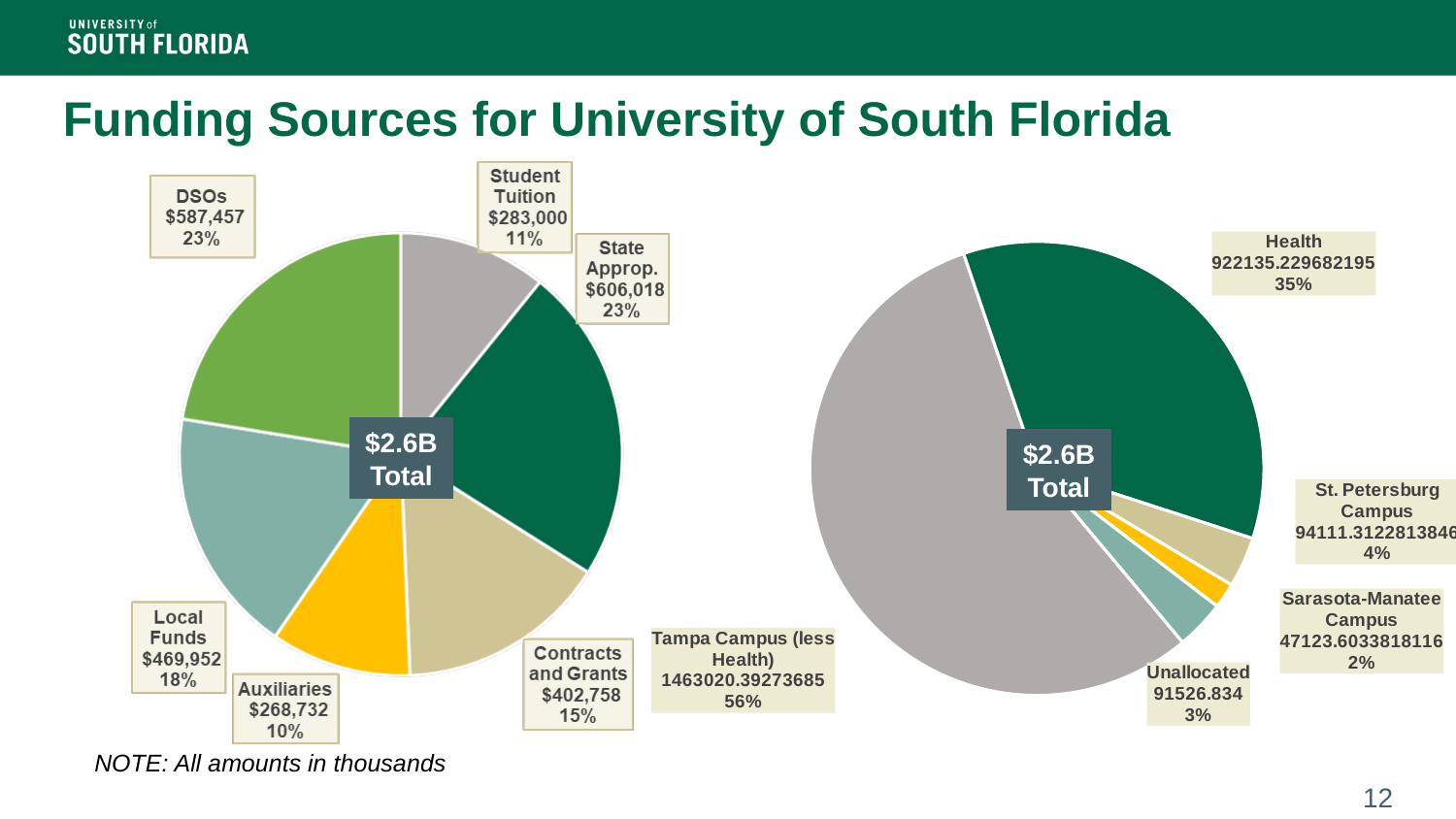
On the right pie chart, which category has the largest share? Tampa Campus (less Health) On the left pie chart, which is larger: Local Funds or Contracts and Grants? Local Funds On the left pie chart, what percentage share does State Approp. have? 23% On the right pie chart, which category has the smallest share? Sarasota-Manatee Campus What total is shown in the center of each pie chart? $2.6B Total How many slices does the right pie chart have? 5 On the left pie chart, which funding source has the smallest value? Auxiliaries How many slices does the left pie chart have? 6 What type of chart is used on this slide? Pie chart On the right pie chart, what percentage share does Health have? 35% On the left pie chart, what is the difference between State Approp. and Student Tuition? $323,018 On the left pie chart, what is the value shown for DSOs? $587,457